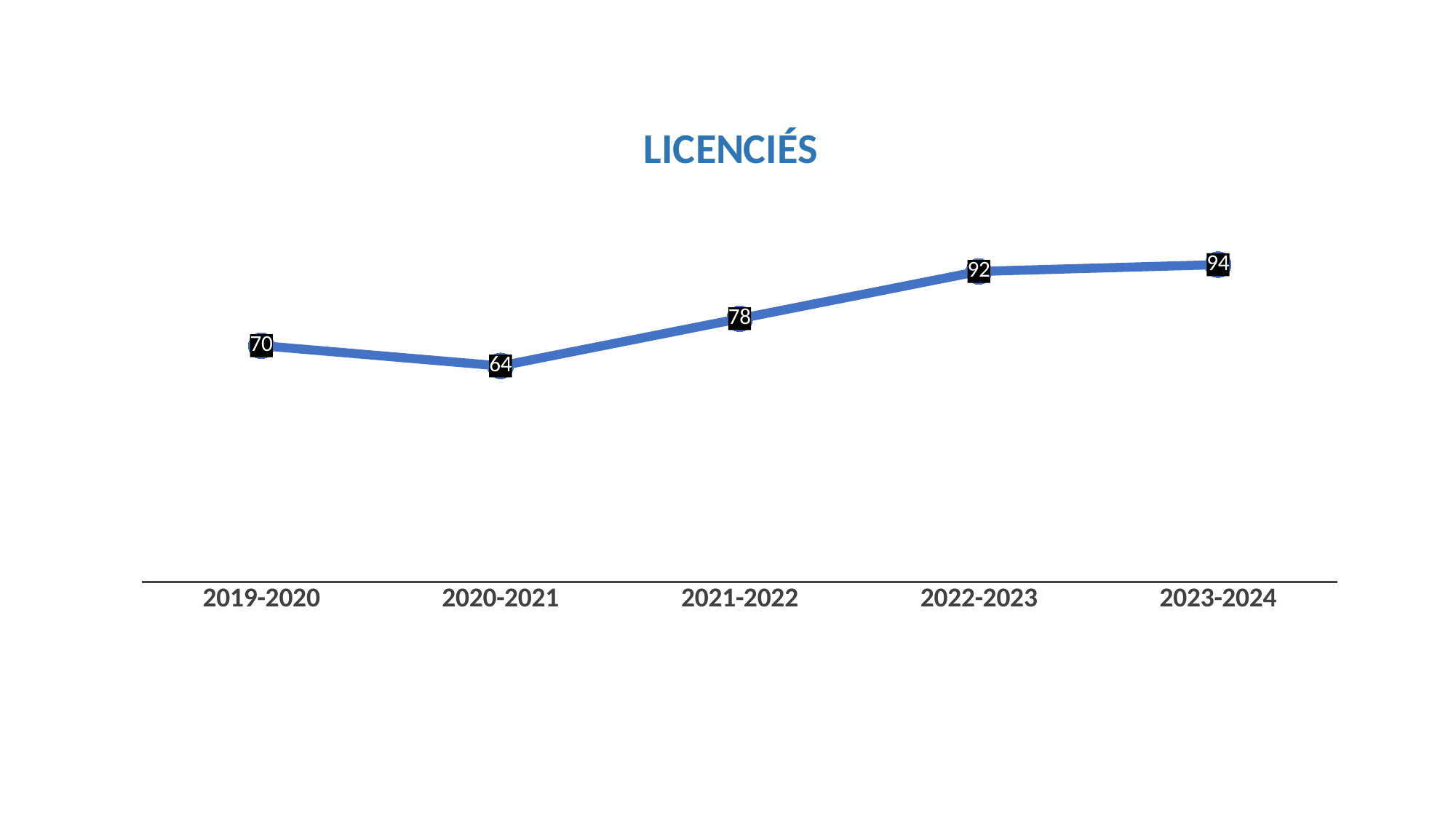
What is the title of the chart? LICENCIÉS What is the value for 2020-2021? 64 What is the value for 2023-2024? 94 What is the value for 2021-2022? 78 Which season has the lowest value? 2020-2021 What kind of chart is shown? line chart How many seasons are plotted on the chart? 5 Which is larger, the value for 2019-2020 or the value for 2021-2022? 2021-2022 Which season has the highest value? 2023-2024 What is the difference between the values for 2022-2023 and 2020-2021? 28 What is the value for 2019-2020? 70 What is the value for 2022-2023? 92